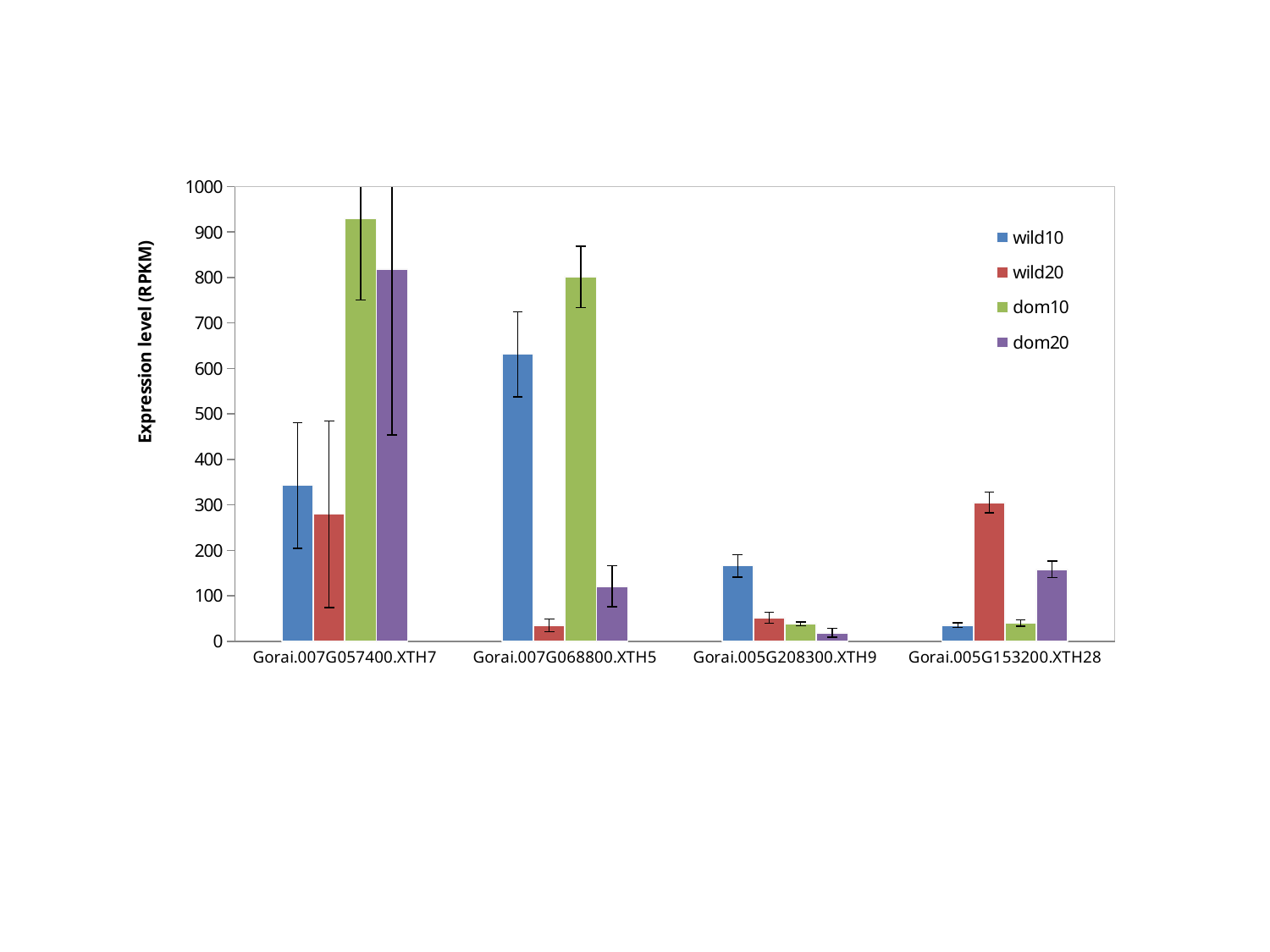
Is the dom10 value for Gorai.007G057400.XTH7 greater or less than 800? greater What is the label of the y axis? Expression level (RPKM) For Gorai.005G153200.XTH28, which is larger, wild20 or dom20? wild20 Which series has the highest bar for Gorai.005G153200.XTH28? wild20 Is the wild20 value for Gorai.007G068800.XTH5 greater or less than 100? less What kind of chart is shown on the slide? bar chart Which series has the lowest bar for Gorai.005G208300.XTH9? dom20 For Gorai.007G057400.XTH7, which is larger, dom10 or dom20? dom10 How many gene categories are shown on the x axis? 4 Is the wild10 value for Gorai.007G068800.XTH5 greater or less than 500? greater Which gene has the highest dom10 bar? Gorai.007G057400.XTH7 How many series does the legend list? 4